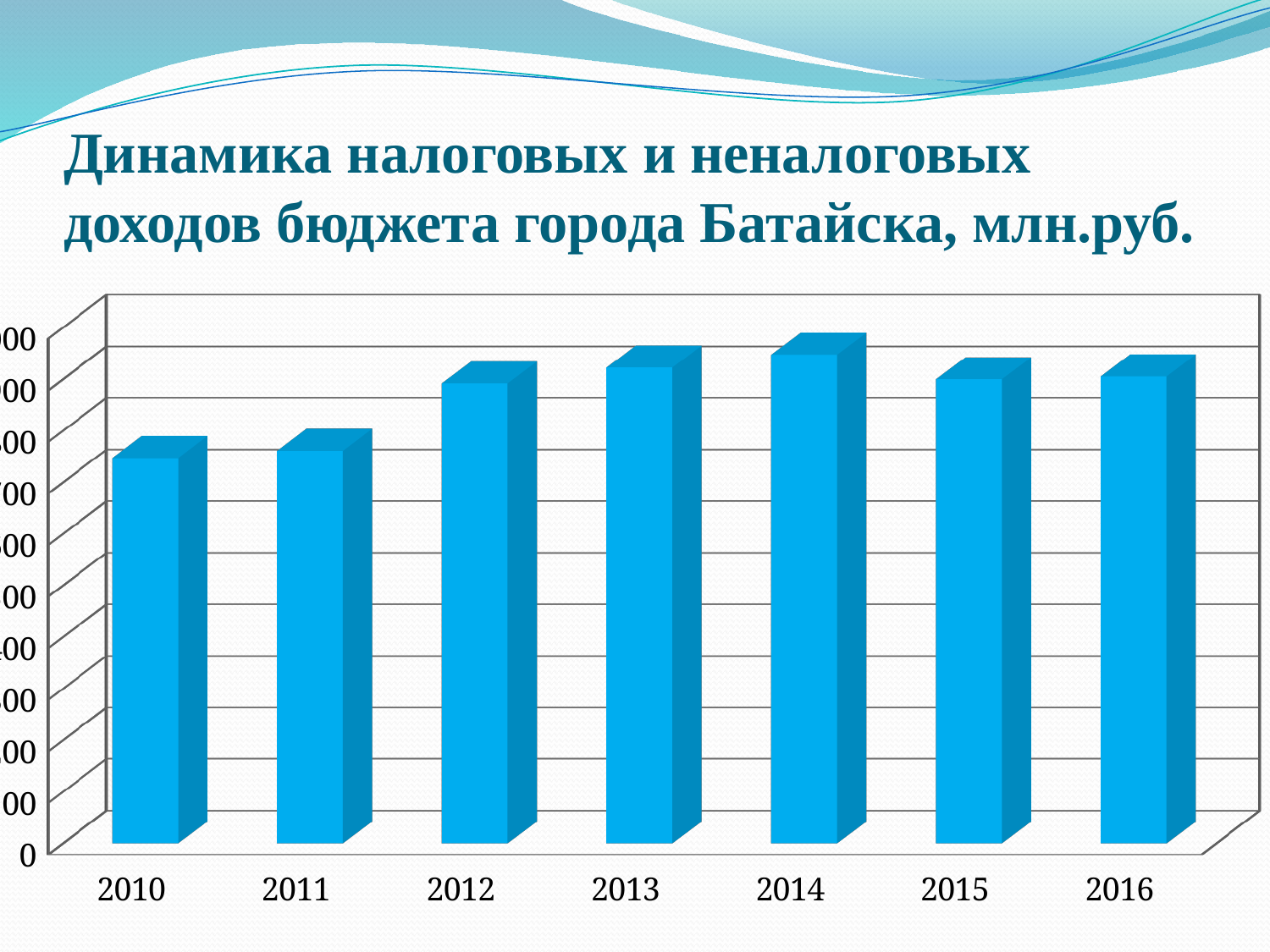
How many years are shown on the x axis of the chart? 7 Which year has the lowest value in the chart? 2010 What kind of chart is shown on the slide? bar chart Which year has the larger value, 2011 or 2012? 2012 What is the first year shown on the x axis of the chart? 2010 Do the values rise or fall from 2010 to 2014? rise In what units are the values in the chart expressed, according to the slide title? млн.руб. Which year has the highest value in the chart? 2014 Which year has the larger value, 2013 or 2015? 2013 Do the values rise or fall from 2014 to 2015? fall Which year has the larger value, 2010 or 2014? 2014